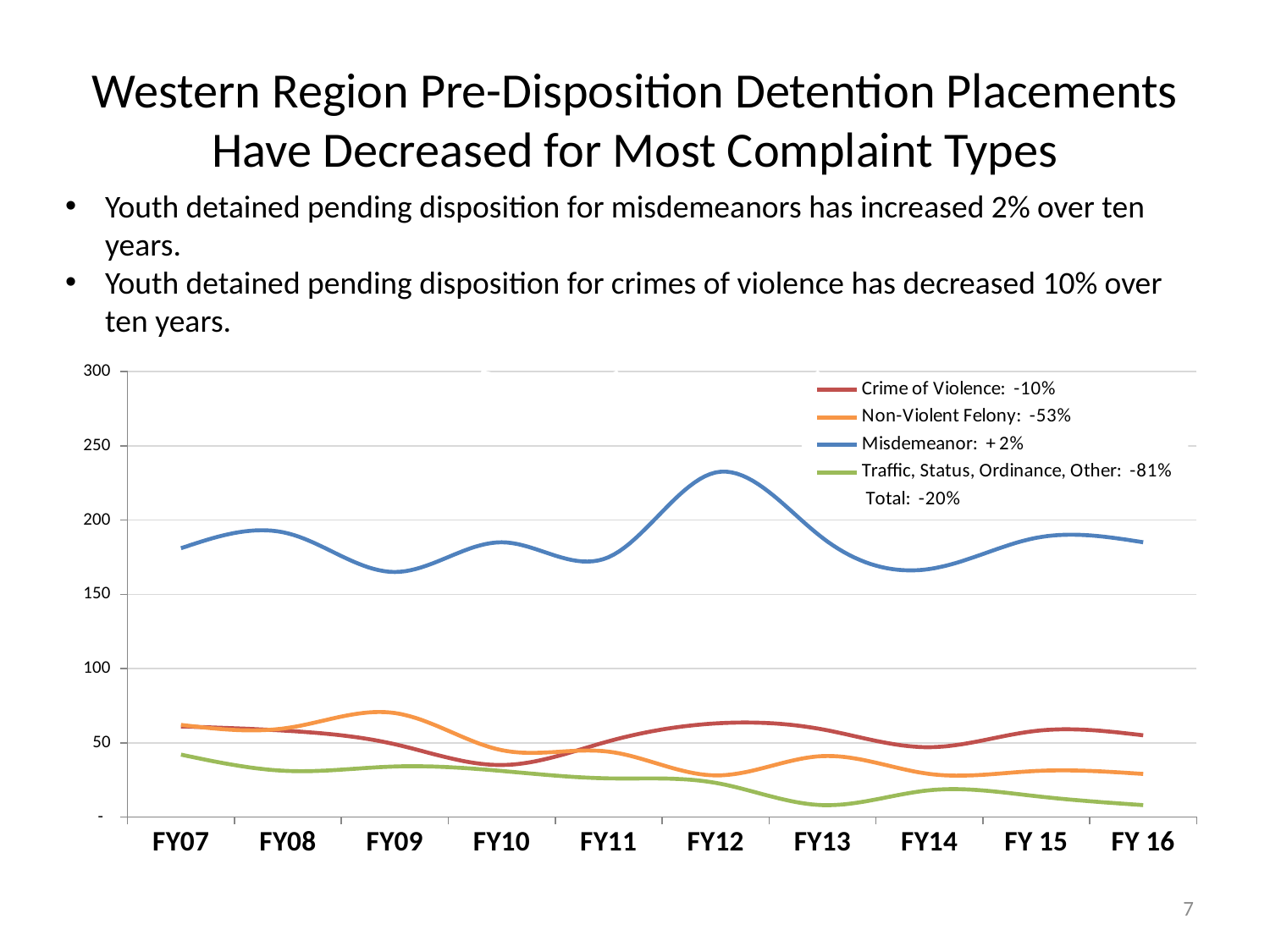
In FY09, which is larger: Non-Violent Felony or Crime of Violence? Non-Violent Felony What percentage change does the legend show for Non-Violent Felony? -53% Is the Misdemeanor value for FY09 greater or less than 200? less Does the Traffic, Status, Ordinance, Other line generally rise or fall from FY07 to FY16? fall Is the value for Traffic, Status, Ordinance, Other in FY13 greater or less than 50? less What kind of chart is shown on the slide? line chart Which series has the lowest value in FY16? Traffic, Status, Ordinance, Other In which fiscal year does the Misdemeanor line reach its peak? FY12 In FY16, which is larger: Crime of Violence or Traffic, Status, Ordinance, Other? Crime of Violence How many fiscal years are shown on the x axis of the chart? 10 Is the Misdemeanor value for FY12 greater or less than 200? greater Which series has the highest values throughout the chart? Misdemeanor